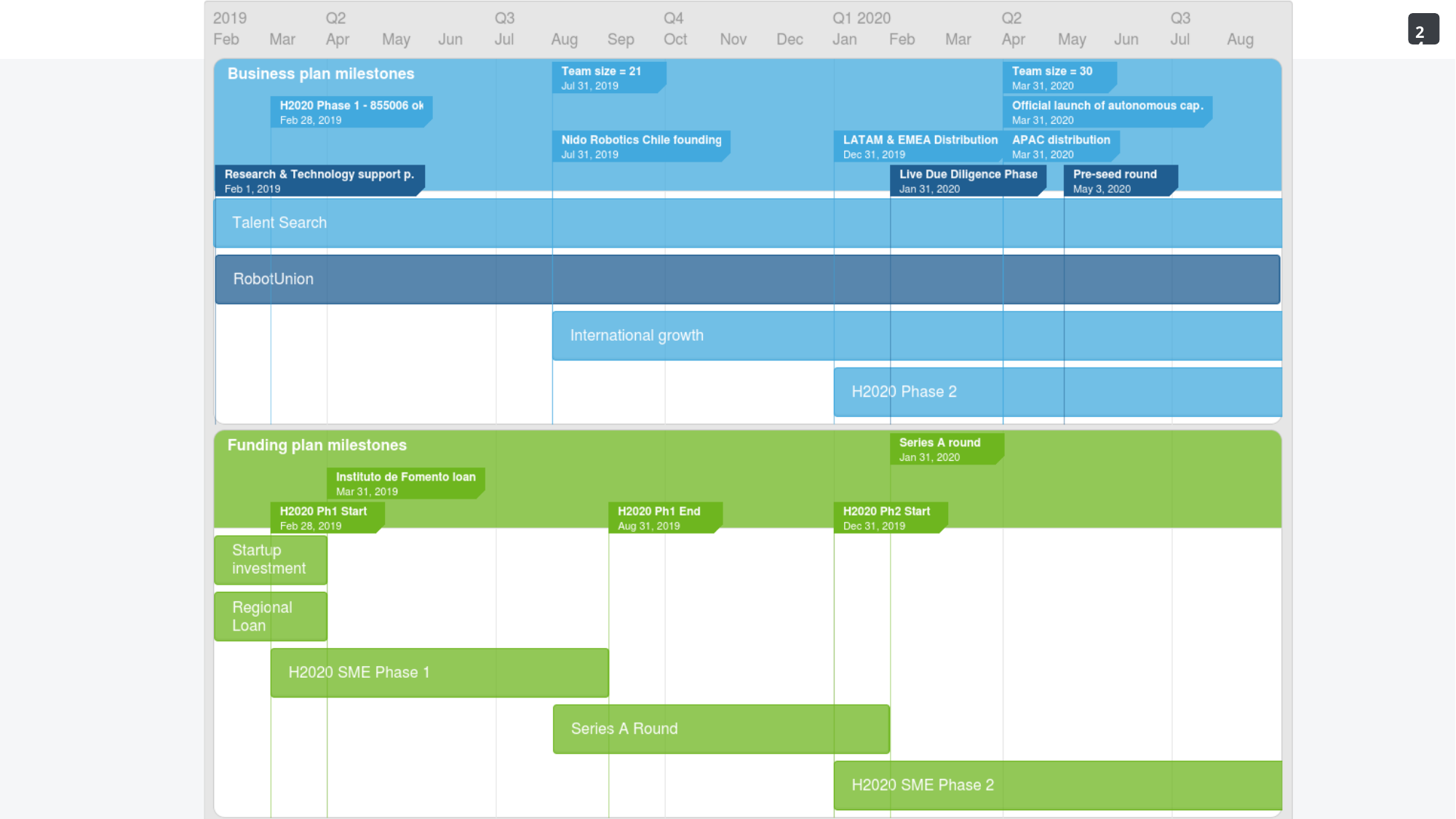
In the Funding plan milestones section, what date is given for the 'H2020 Ph1 End' milestone? Aug 31, 2019 In the Business plan milestones section, what date is given for the 'Pre-seed round' milestone? May 3, 2020 In the Funding plan milestones section, what date is given for the 'Instituto de Fomento loan' milestone? Mar 31, 2019 In the Business plan milestones section, what date is given for the 'Team size = 21' milestone? Jul 31, 2019 What kind of chart is shown on the slide? Gantt chart (timeline) Which milestone comes earlier: 'LATAM & EMEA Distribution' or 'APAC distribution'? LATAM & EMEA Distribution What are the titles of the two sections of the timeline? Business plan milestones and Funding plan milestones In the Business plan milestones section, what date is given for the 'Nido Robotics Chile founding' milestone? Jul 31, 2019 How many task bars are shown in the Business plan milestones section? 4 Which task bar in the Business plan milestones section starts latest on the timeline? H2020 Phase 2 In the Business plan milestones section, what date is given for the 'Team size = 30' milestone? Mar 31, 2020 How many task bars are shown in the Funding plan milestones section? 5